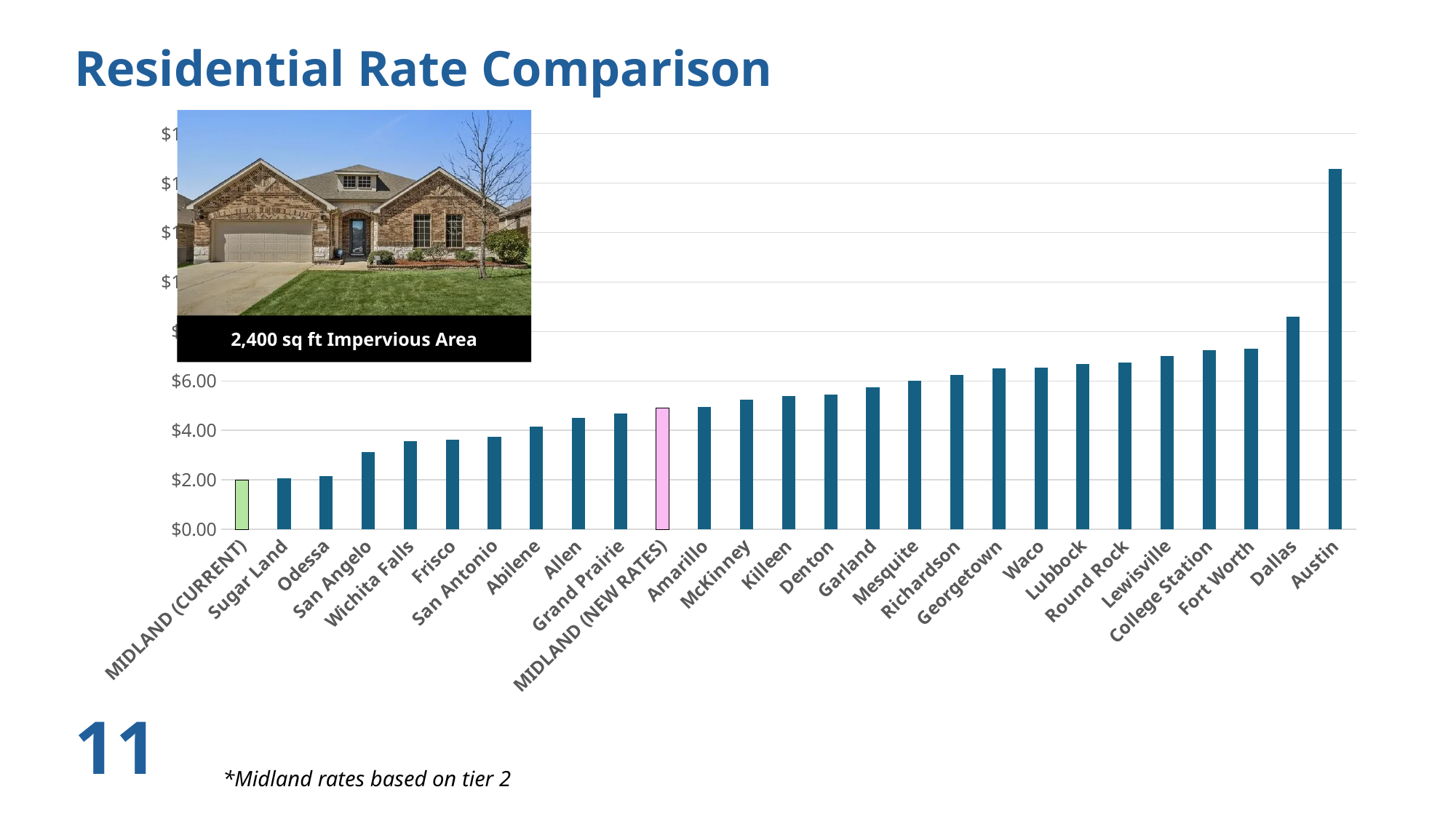
Which city has the highest residential rate in the chart? Austin What colour is the bar for MIDLAND (NEW RATES)? Pink Is the value for Grand Prairie greater or less than $6.00? less What kind of chart is shown on the slide? Bar chart Is the value for Austin greater or less than $6.00? greater Which is larger, the value for Dallas or the value for Austin? Austin Do the bar values generally rise or fall from left to right along the x axis? Rise Which category has the lowest value in the chart? MIDLAND (CURRENT) Which is larger, the value for MIDLAND (NEW RATES) or the value for MIDLAND (CURRENT)? MIDLAND (NEW RATES) How many categories are plotted along the x axis? 27 Is the value for Odessa greater or less than $4.00? less